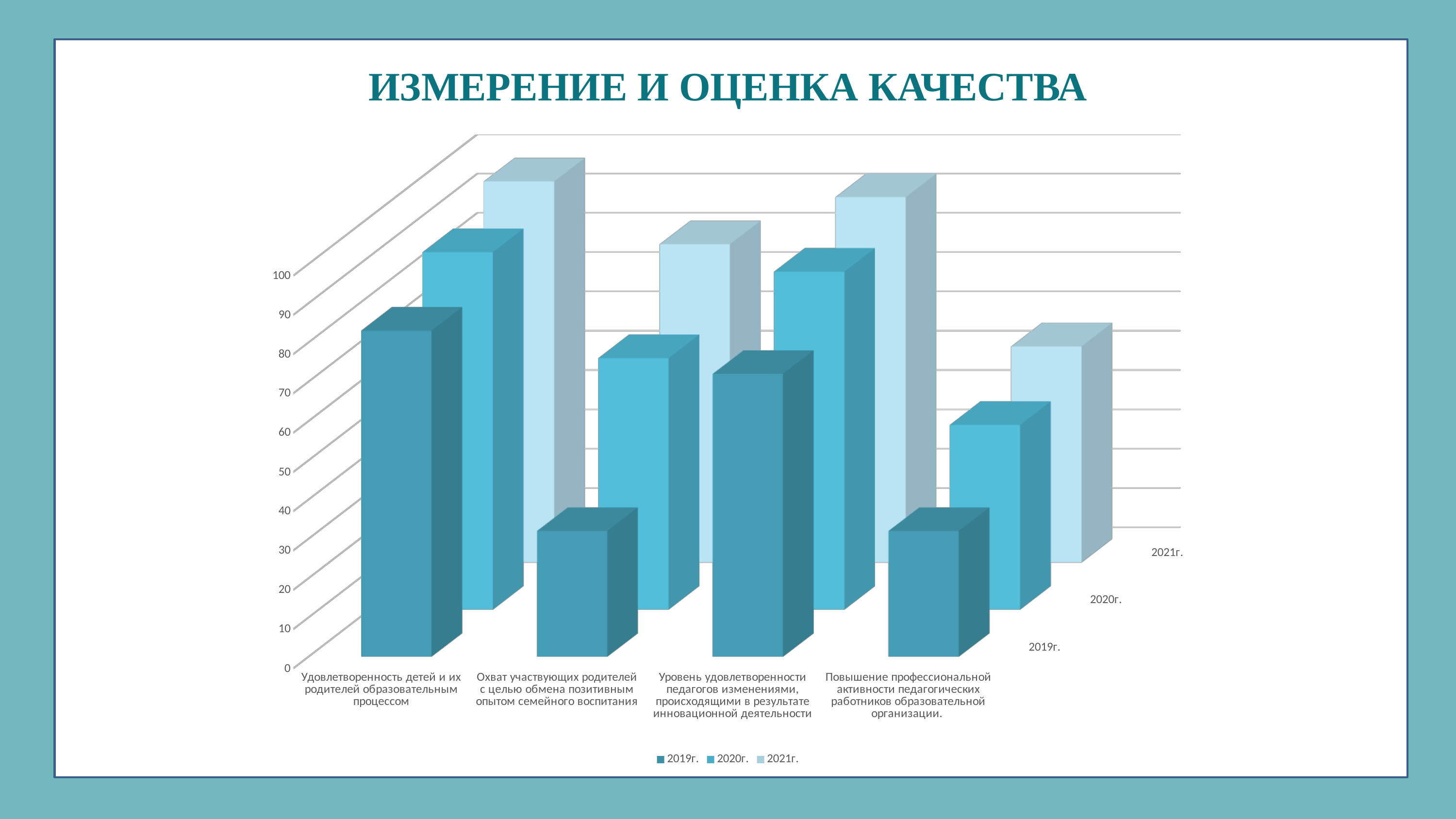
For the 2019г. series, which is larger: the value for "Уровень удовлетворенности педагогов изменениями, происходящими в результате инновационной деятельности" or the value for "Повышение профессиональной активности педагогических работников образовательной организации."? Уровень удовлетворенности педагогов изменениями, происходящими в результате инновационной деятельности What kind of chart is shown on the slide? bar chart Is the 2019г. value for "Охват участвующих родителей с целью обмена позитивным опытом семейного воспитания" greater or less than 50? less How many series does the chart legend list? 3 How many categories are shown on the x axis of the chart? 4 Is the 2019г. value for "Повышение профессиональной активности педагогических работников образовательной организации." greater or less than 50? less What is the title of the slide containing the chart? ИЗМЕРЕНИЕ И ОЦЕНКА КАЧЕСТВА Is the 2019г. value for "Удовлетворенность детей и их родителей образовательным процессом" greater or less than 50? greater Which series are listed in the chart legend? 2019г., 2020г., 2021г. For the 2019г. series, which category has the highest value? Удовлетворенность детей и их родителей образовательным процессом For the 2019г. series, which is larger: the value for "Удовлетворенность детей и их родителей образовательным процессом" or the value for "Охват участвующих родителей с целью обмена позитивным опытом семейного воспитания"? Удовлетворенность детей и их родителей образовательным процессом